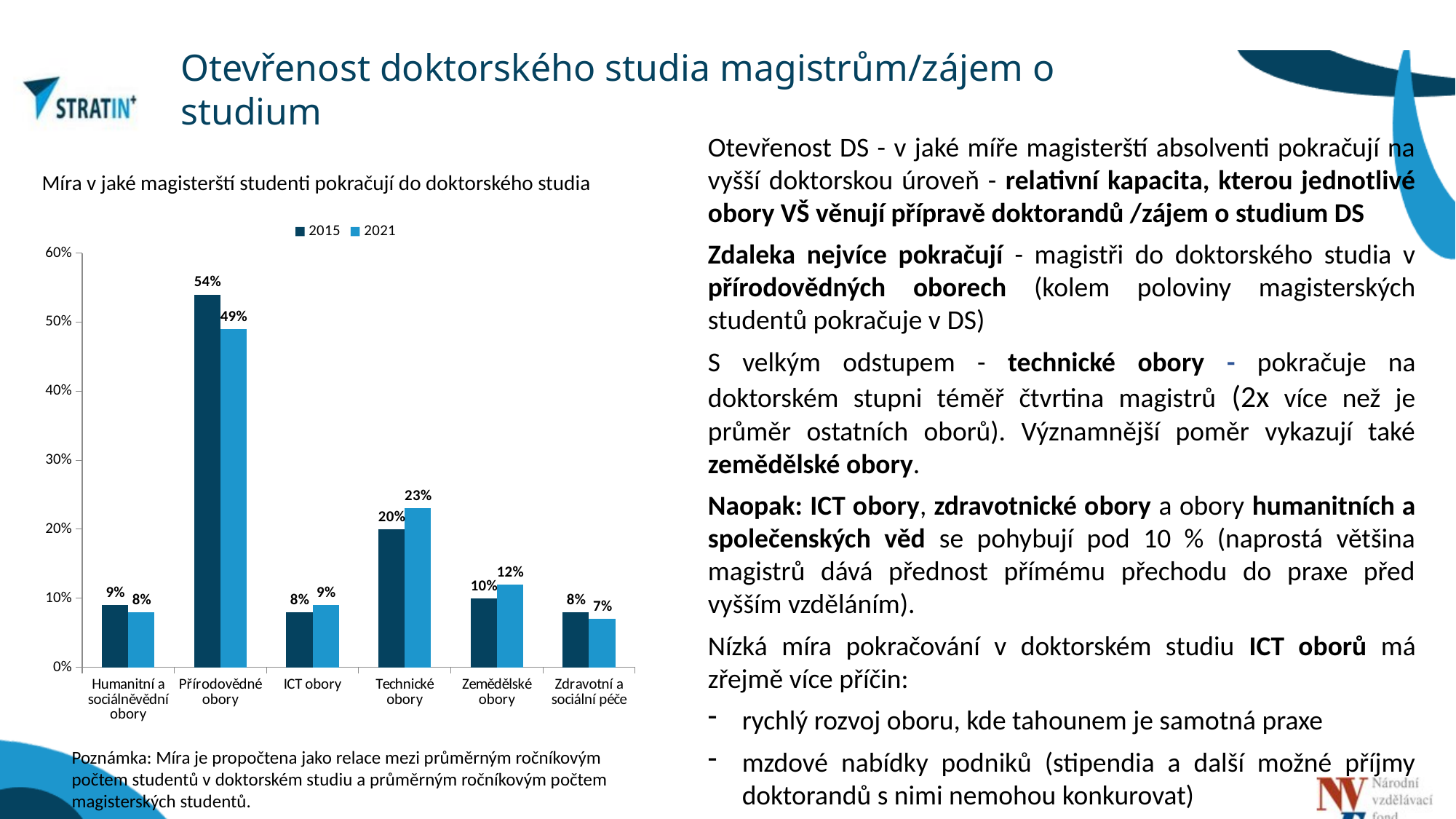
How many categories are shown on the x axis? 6 Which category has the highest 2021 value? Přírodovědné obory What is the 2015 value for Přírodovědné obory? 54% How many series does the legend list? 2 What kind of chart is shown on the slide? Bar chart What is the difference between the 2015 and 2021 values for Přírodovědné obory? 5% What is the 2021 value for Zemědělské obory? 12% What is the 2015 value for Zdravotní a sociální péče? 8% What are the two series listed in the legend? 2015 and 2021 Which category has the lowest 2021 value? Zdravotní a sociální péče What is the 2021 value for Technické obory? 23% Which is larger for ICT obory: the 2015 value or the 2021 value? 2021